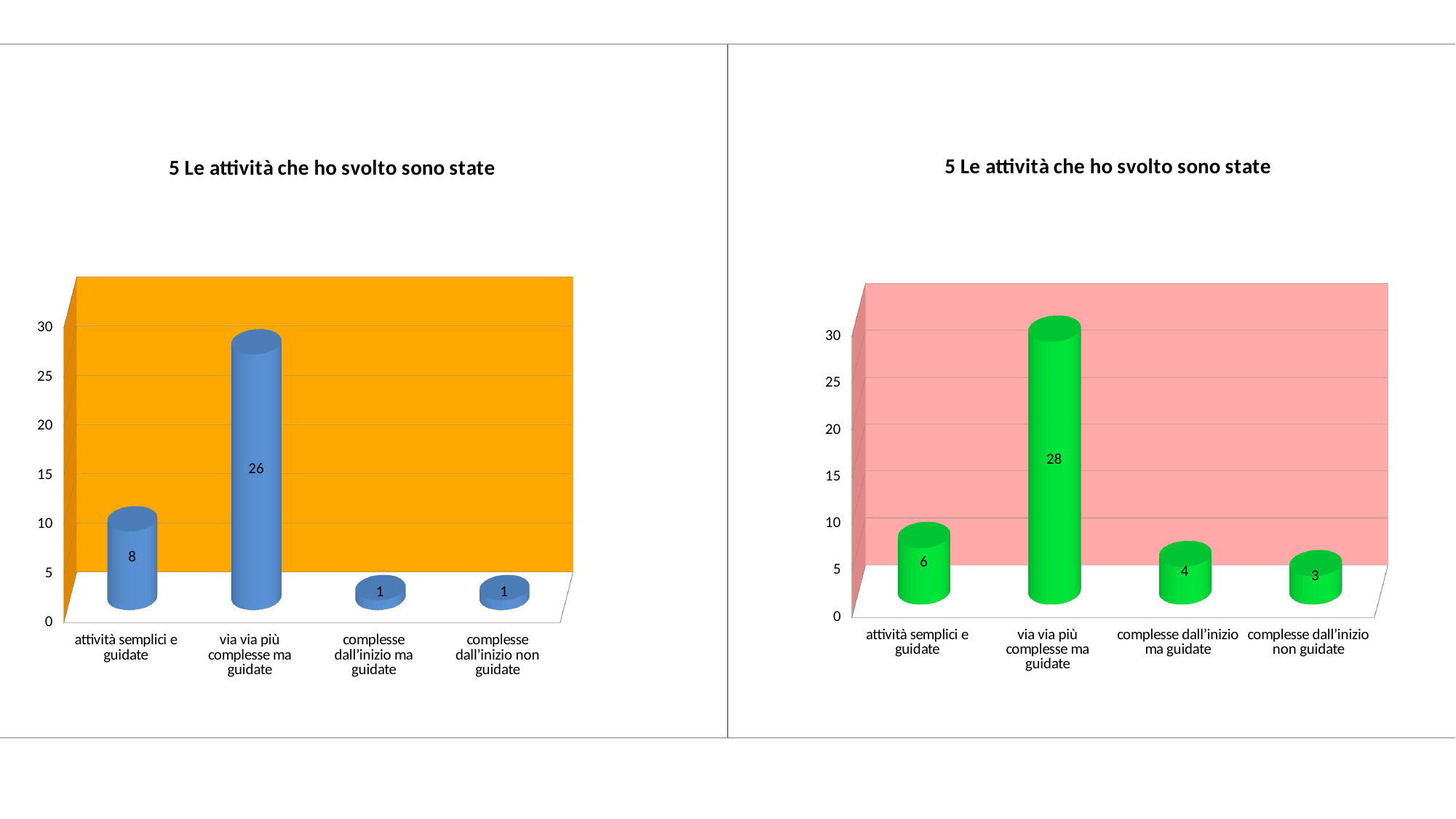
How many categories are shown in the left chart? 4 In the right chart, what is the value for "attività semplici e guidate"? 6 In the left chart, what is the difference between the values for "via via più complesse ma guidate" and "attività semplici e guidate"? 18 What kind of chart is the right chart? bar chart In the left chart, what is the value for "via via più complesse ma guidate"? 26 What colour are the bars in the right chart? green In the right chart, which category has the lowest value? complesse dall'inizio non guidate In the right chart, what is the difference between the values for "via via più complesse ma guidate" and "complesse dall'inizio ma guidate"? 24 In the left chart, which category has the highest value? via via più complesse ma guidate In the right chart, which is larger: the value for "attività semplici e guidate" or the value for "complesse dall'inizio ma guidate"? attività semplici e guidate In the right chart, what is the value for "complesse dall'inizio non guidate"? 3 What is the title of the left chart? 5 Le attività che ho svolto sono state